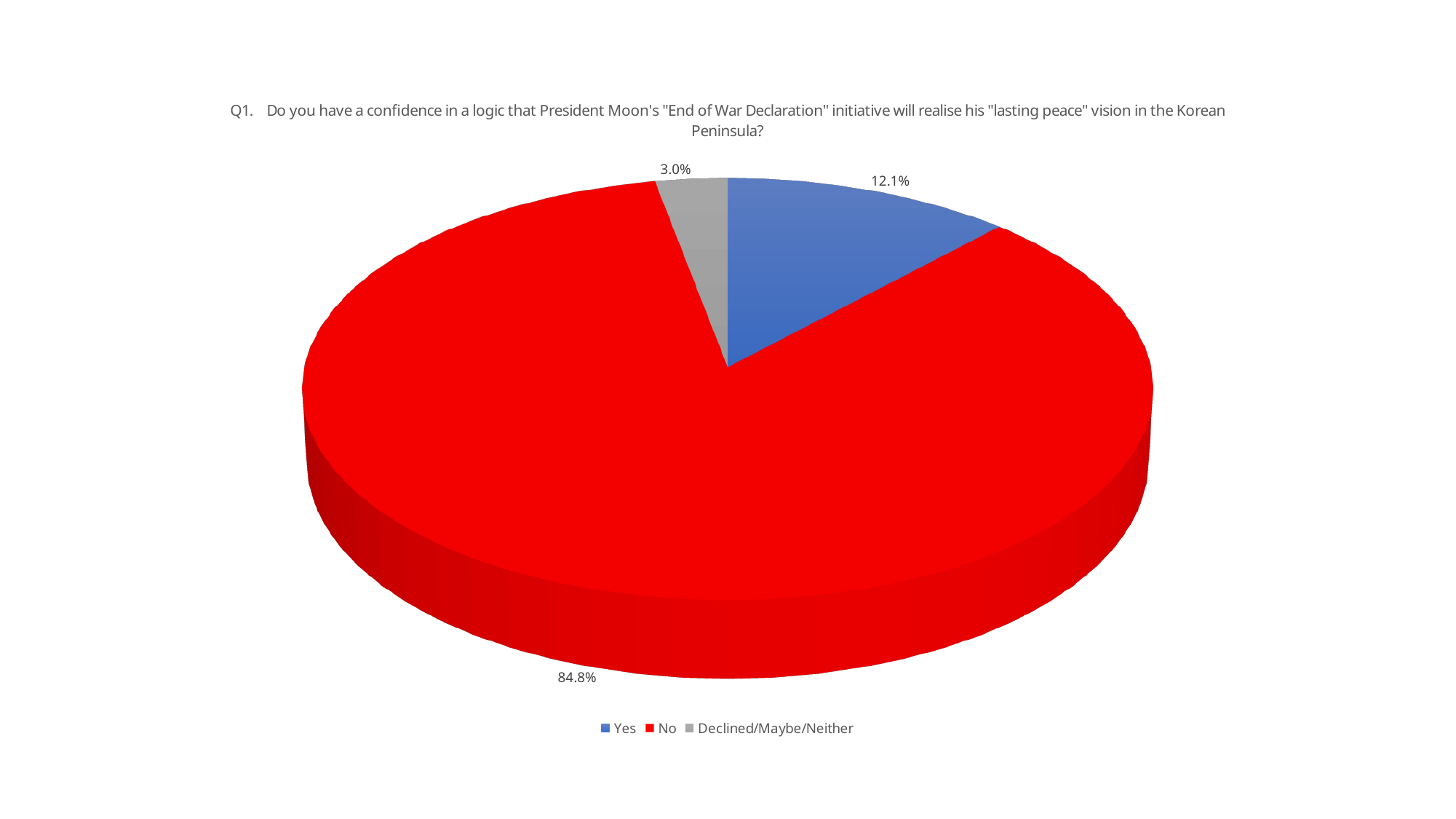
What share of the pie does the "No" slice represent? 84.8% What kind of chart is shown on the slide? Pie chart What colour is the "No" slice? Red What is the difference in percentage points between the "No" and "Yes" slices? 72.7 What share of the pie does the "Yes" slice represent? 12.1% What share of the pie does the "Declined/Maybe/Neither" slice represent? 3.0% What is the difference in percentage points between the "Yes" and "Declined/Maybe/Neither" slices? 9.1 Which is larger, the "Yes" slice or the "Declined/Maybe/Neither" slice? Yes Which category has the largest slice of the pie? No What is the third entry listed in the legend? Declined/Maybe/Neither Which category has the smallest slice of the pie? Declined/Maybe/Neither How many categories does the pie chart have? 3